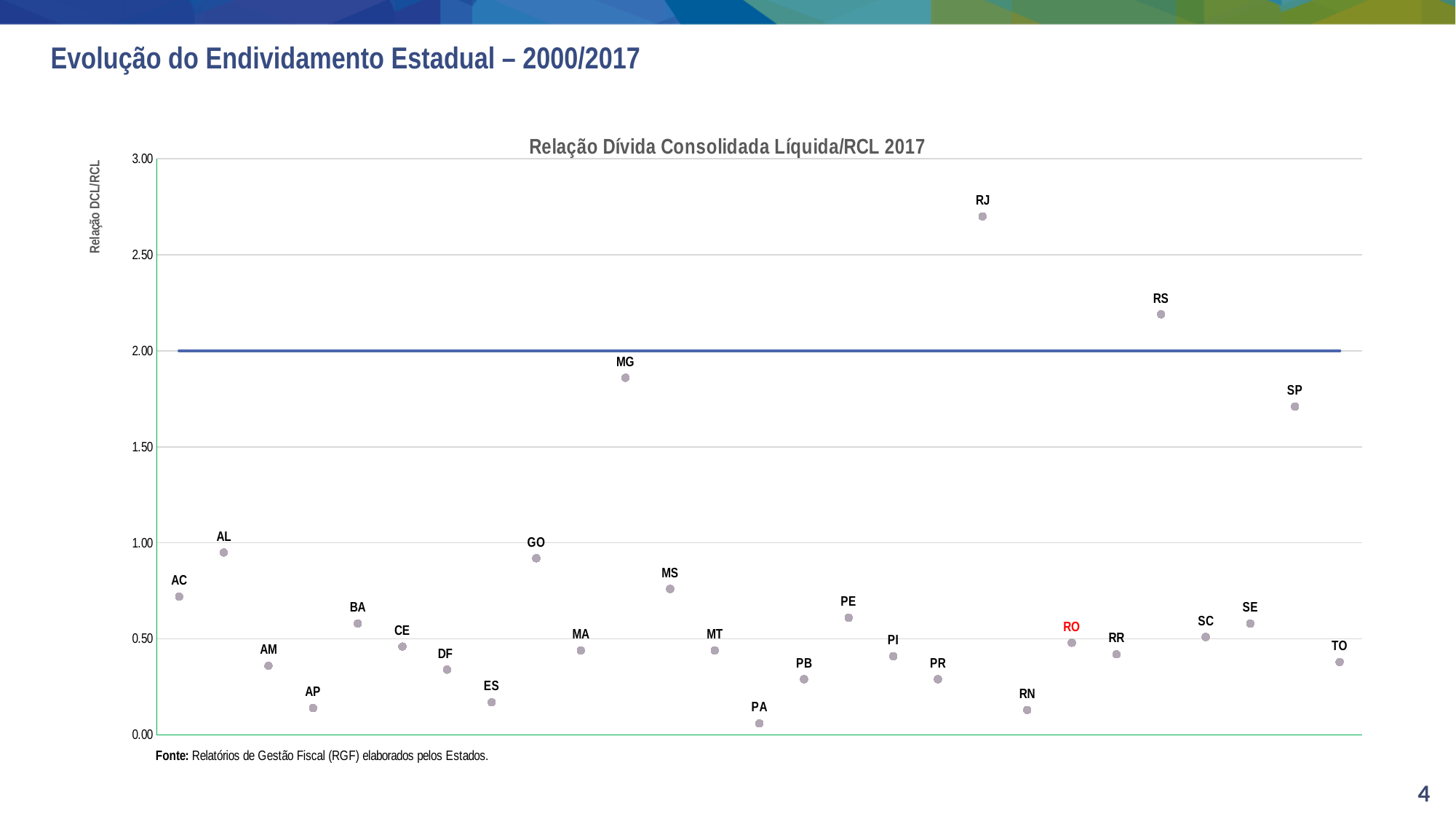
Which has a higher value, MG or SP? MG Is the value for AP greater or less than 0.50? less Which state has the lowest Relação DCL/RCL value? PA How many states are plotted on the chart? 27 At what value on the y axis is the horizontal blue line drawn? 2.00 Is the value for RJ greater or less than 2.50? greater Is the value for MG greater or less than 2.00? less Which state has the highest Relação DCL/RCL value? RJ What is the title of the chart? Relação Dívida Consolidada Líquida/RCL 2017 What kind of chart is shown on the slide? scatter chart Which has a higher value, GO or MS? GO